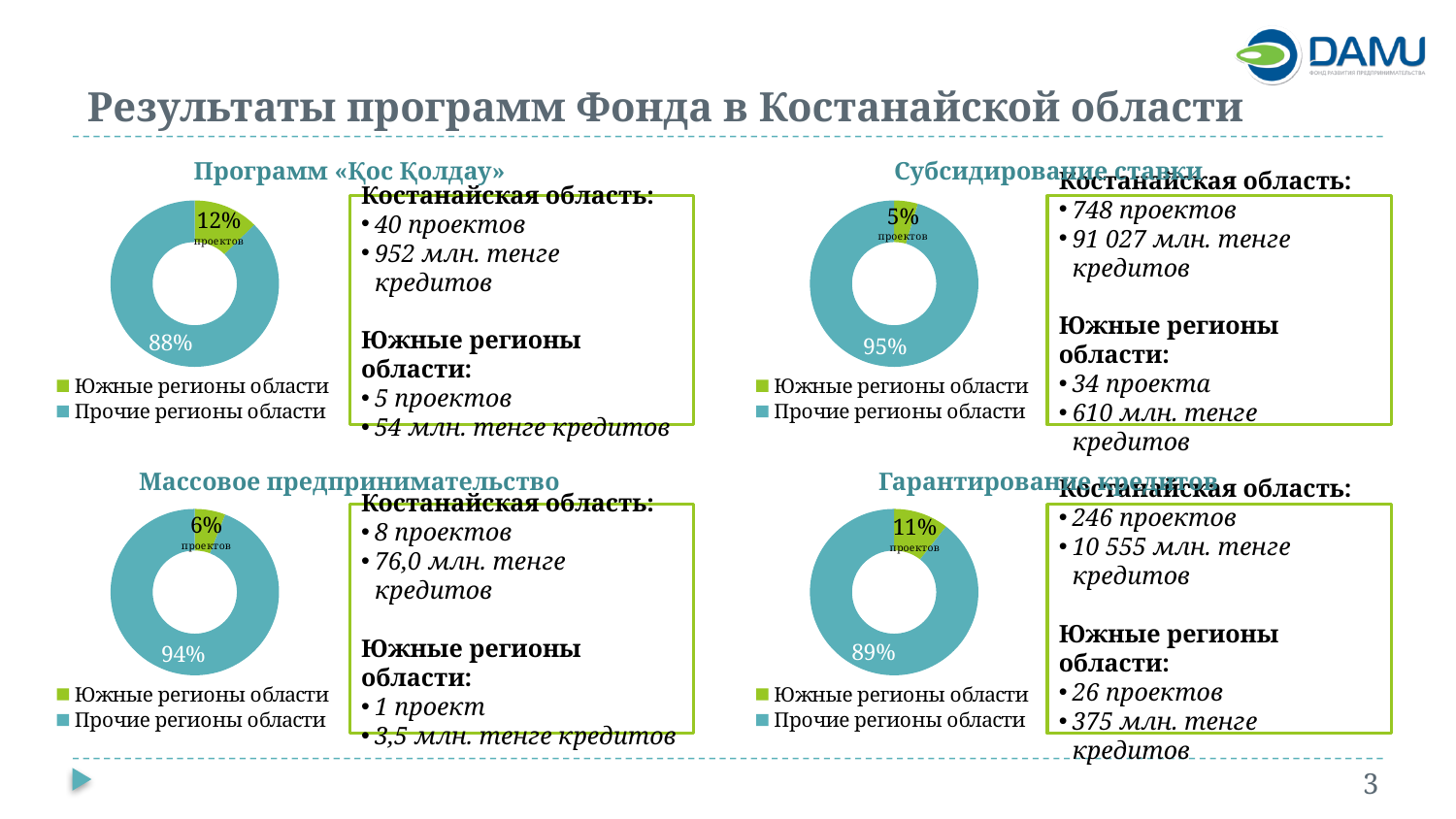
In the top-right chart (Субсидирование ставки), which slice is the smallest? Южные регионы области In the top-left chart (Программ «Қос Қолдау»), what share is shown for Прочие регионы области? 88% In the top-left chart (Программ «Қос Қолдау»), what is the difference between the shares of Прочие регионы области and Южные регионы области? 76% How many categories does the legend of the bottom-right chart (Гарантирование кредитов) list? 2 What type of chart is used in the top-right chart (Субсидирование ставки)? Pie (donut) chart In the bottom-left chart (Массовое предпринимательство), what colour is the slice for Южные регионы области? Green In the top-right chart (Субсидирование ставки), what share is shown for Южные регионы области? 5% In the bottom-left chart (Массовое предпринимательство), which is larger: the share for Южные регионы области or for Прочие регионы области? Прочие регионы области In the bottom-right chart (Гарантирование кредитов), which slice is the largest? Прочие регионы области In the bottom-left chart (Массовое предпринимательство), what share is shown for Прочие регионы области? 94% In the top-left chart (Программ «Қос Қолдау»), what share is shown for Южные регионы области? 12% In the bottom-right chart (Гарантирование кредитов), what share is shown for Южные регионы области? 11%